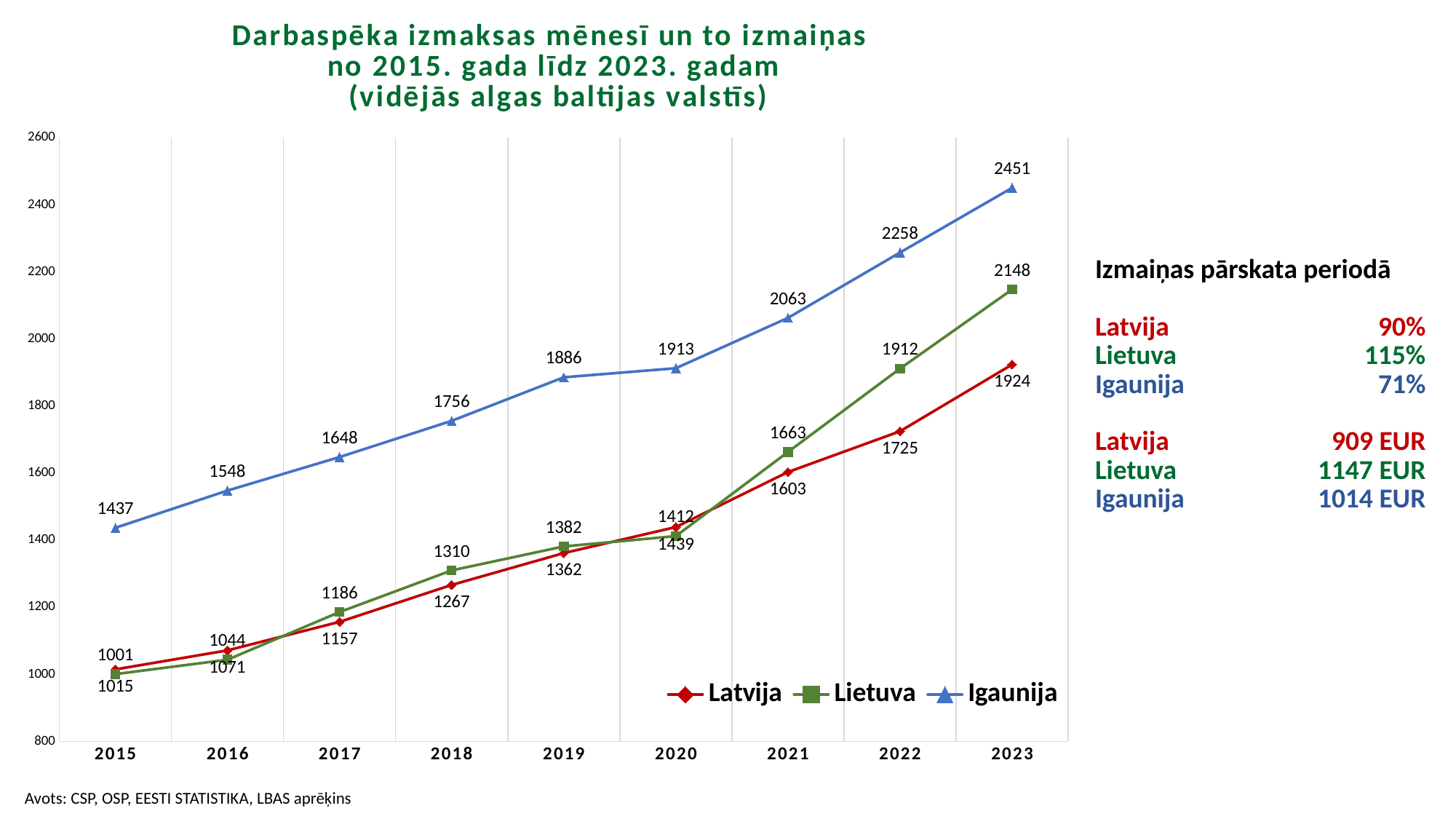
What is the value for Lietuva in 2021? 1663 Which is larger in 2017, the value for Lietuva or the value for Latvija? Lietuva What is the difference between the Igaunija value in 2023 and the Igaunija value in 2015? 1014 Does the Latvija series rise or fall from 2015 to 2023? rise How many years are shown on the x axis? 9 What is the value for Latvija in 2018? 1267 Which series has the highest value in 2023? Igaunija What is the value for Igaunija in 2023? 2451 What type of chart is shown on the slide? line chart Which series has the lowest value in 2022? Latvija How many series does the legend list? 3 According to the text on the right, what is the percentage change for Lietuva over the reporting period? 115%